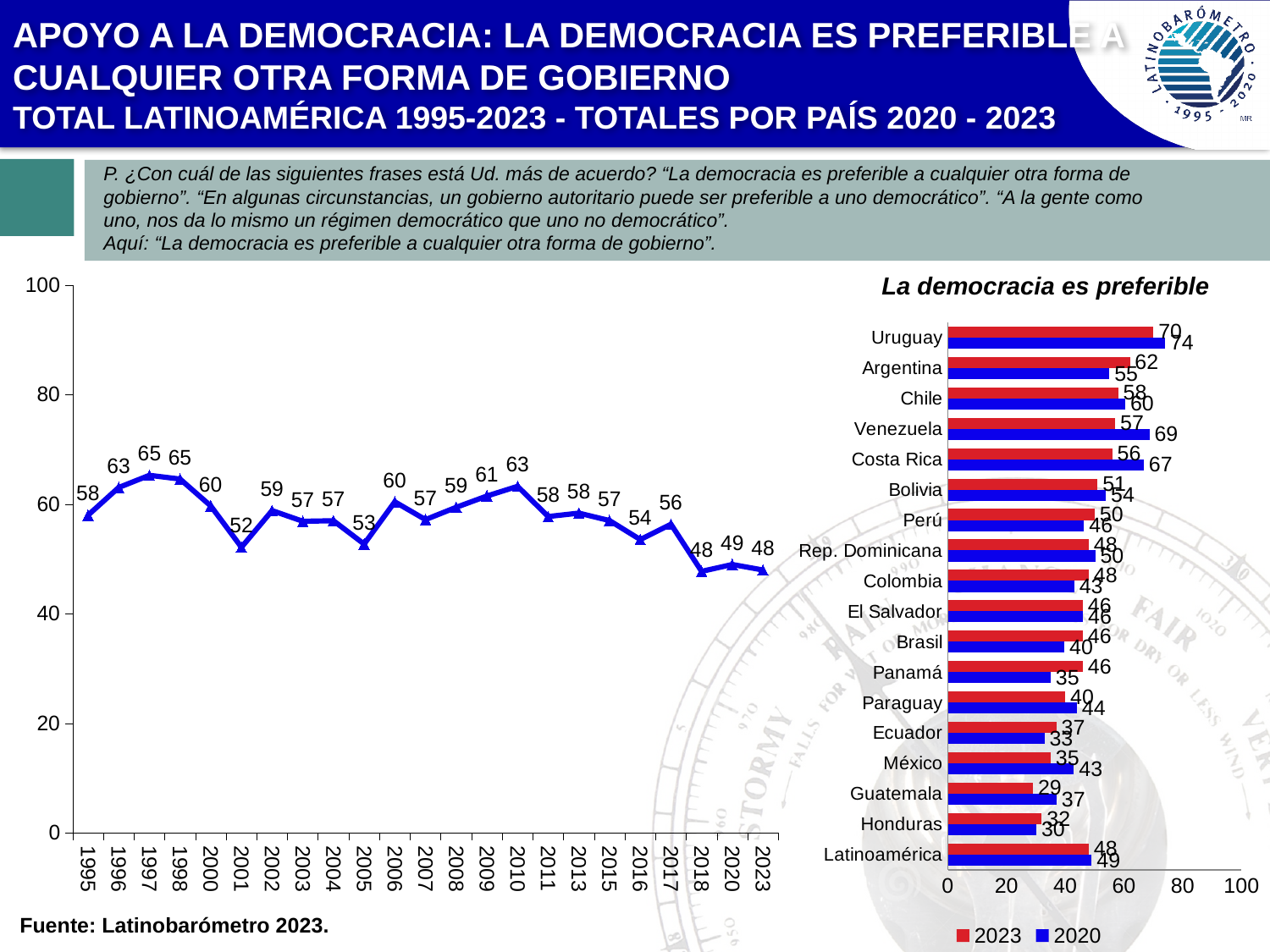
On the right bar chart 'La democracia es preferible', which country has the lowest 2023 value? Guatemala On the right bar chart 'La democracia es preferible', what is the 2020 value for Venezuela? 69 On the right bar chart 'La democracia es preferible', what is the 2023 value for Uruguay? 70 On the right bar chart 'La democracia es preferible', what is the difference between the 2020 and 2023 values for Costa Rica? 11 On the left line chart, what is the value for 2023? 48 On the left line chart, which year has the lowest value? 2018 and 2023 (48) What kind of chart is the chart on the left of the slide? Line chart On the left line chart, what is the value for 1997? 65 On the left line chart, how many data points are plotted? 23 On the right bar chart 'La democracia es preferible', is the 2023 value for Argentina larger or smaller than its 2020 value? Larger On the left line chart, what is the difference between the 2010 value and the 2018 value? 15 On the right bar chart 'La democracia es preferible', how many series does the legend list? 2